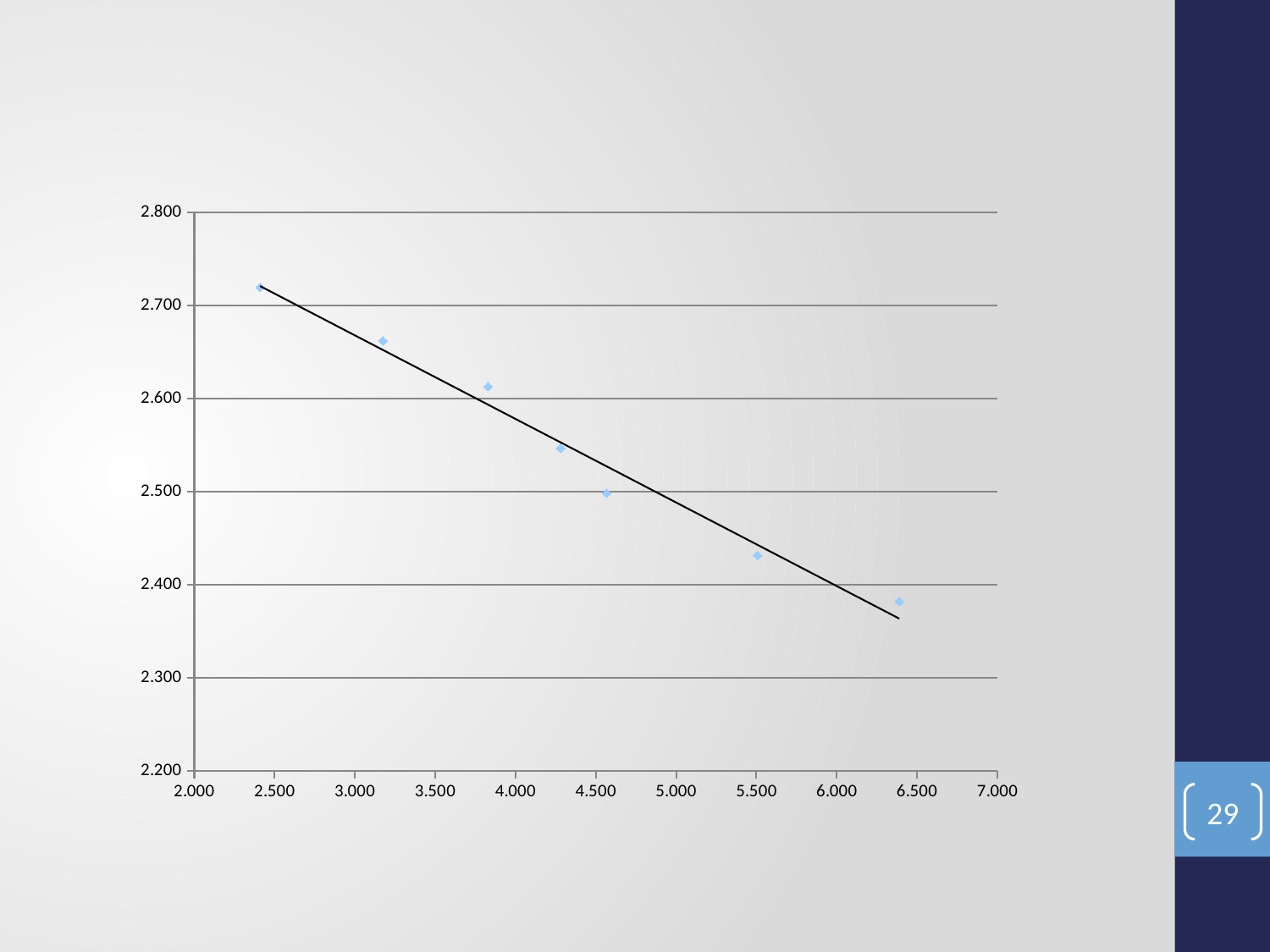
Do the plotted values rise or fall as the x-axis value increases? fall Is the value of the leftmost data point (near x = 2.500) greater or less than 2.700? greater Is the value of the data point near x = 4.300 greater or less than 2.500? greater Is the value of the data point near x = 5.500 greater or less than 2.500? less What kind of chart is shown on the slide? scatter chart Which data point has the highest y value: the leftmost or the rightmost? the leftmost How many data points are plotted on the chart? 7 What is the lowest value shown on the y-axis? 2.200 What is the highest value shown on the x-axis? 7.000